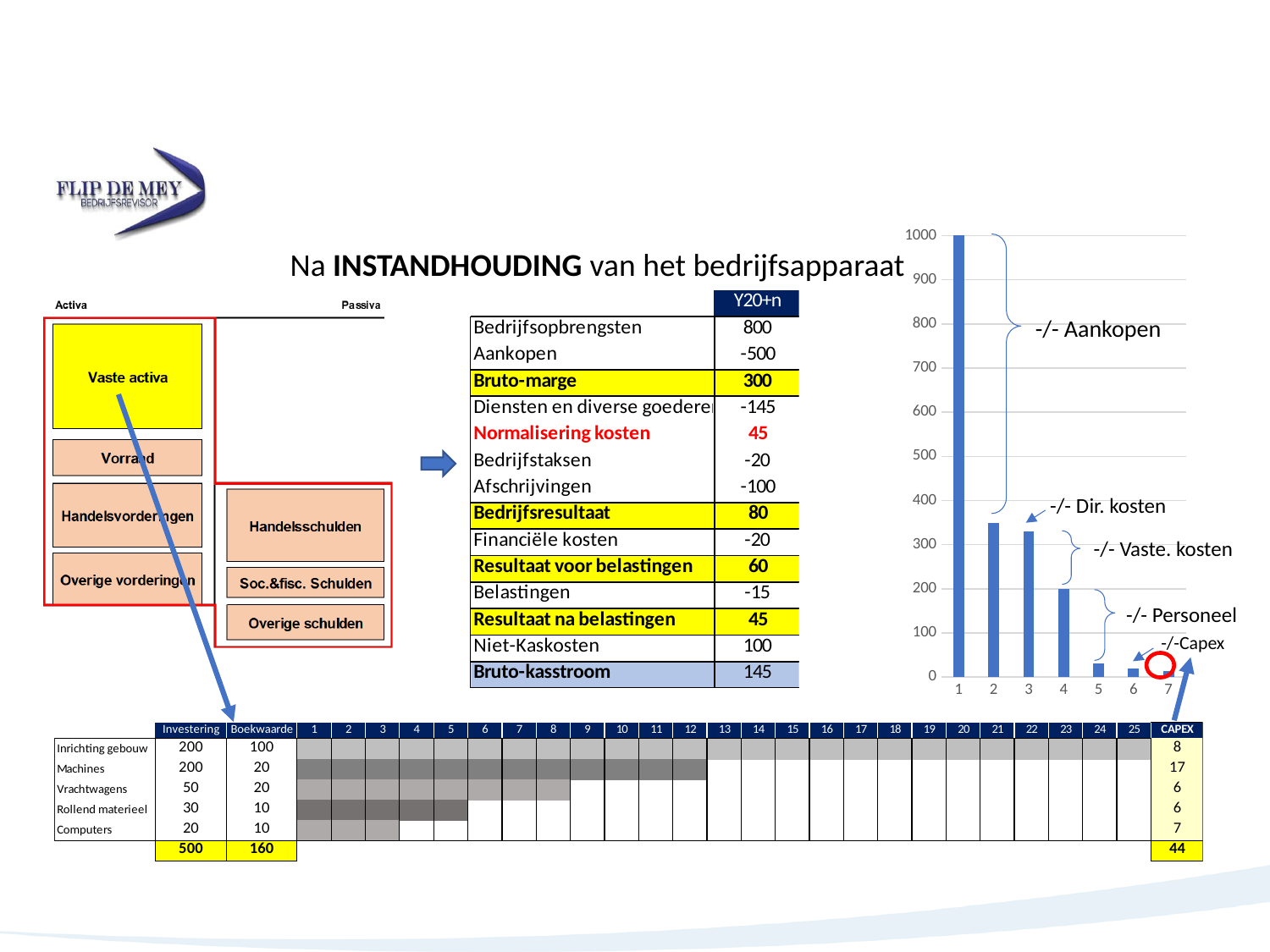
What is the value of the bar for category 1 in the bar chart? 1000 Is the value for category 3 in the bar chart greater or less than 400? less What kind of chart is shown on the right side of the slide? bar chart Is the value for category 5 in the bar chart greater or less than 100? less In the bar chart, which is larger: the bar for category 2 or the bar for category 4? category 2 What annotation is written next to the bracket beside the bar for category 1 in the bar chart? -/- Aankopen Which category has the lowest bar in the bar chart? 7 How many categories are shown on the x axis of the bar chart? 7 Is the value for category 2 in the bar chart greater or less than 300? greater Do the bar values rise or fall as you move from category 1 to category 7 in the bar chart? fall Which category has the highest bar in the bar chart? 1 What is the highest value shown on the y axis of the bar chart? 1000